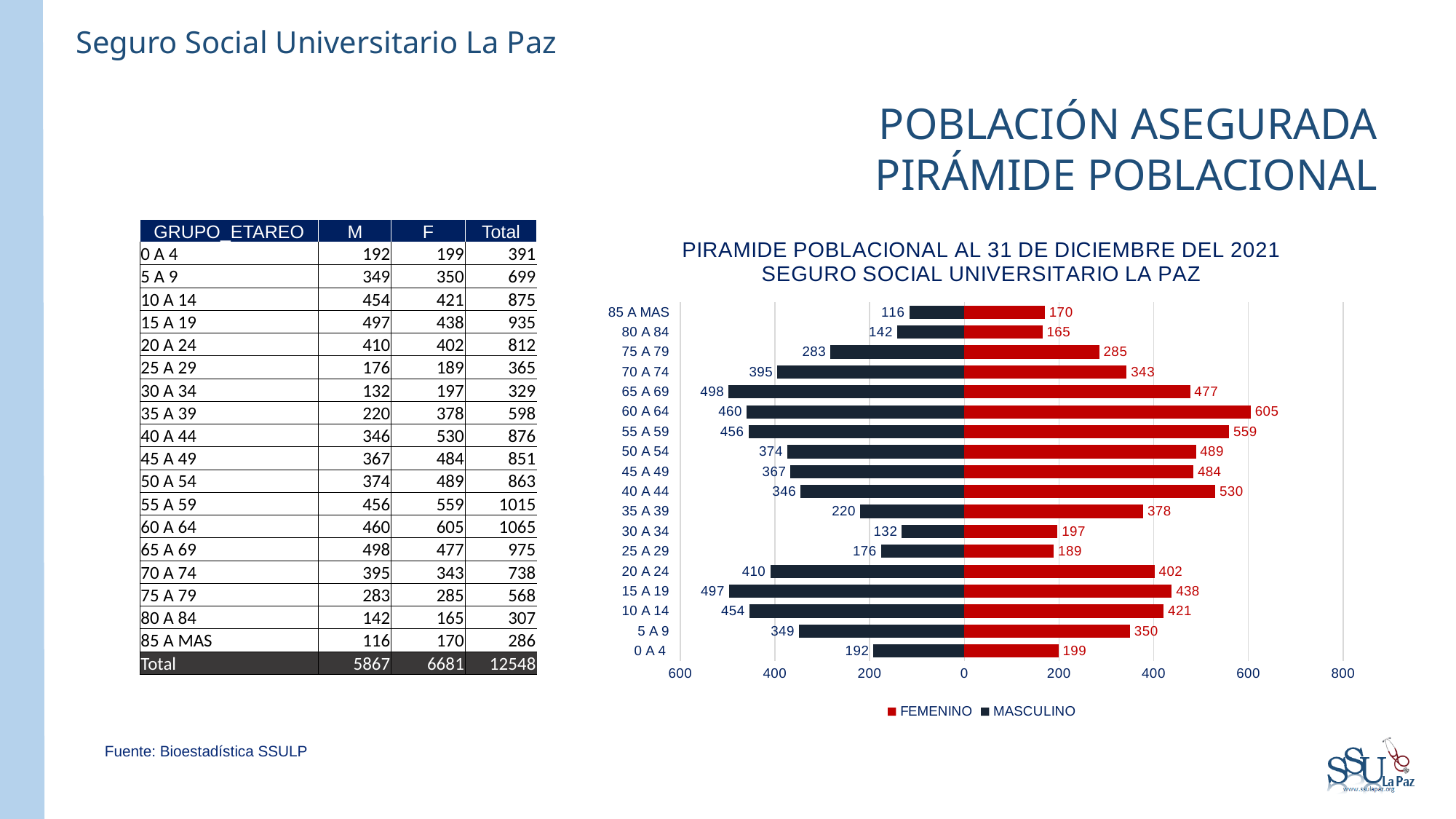
What is the MASCULINO value for the 15 A 19 age group? 497 What is the FEMENINO value for the 85 A MAS age group? 170 How many series does the chart legend list? 2 What colour are the FEMENINO bars in the chart? Red Which age group has the highest FEMENINO value? 60 A 64 What is the FEMENINO value for the 60 A 64 age group? 605 Which age group has the lowest MASCULINO value? 85 A MAS For the 15 A 19 age group, which is larger, the MASCULINO value or the FEMENINO value? MASCULINO Is the FEMENINO value for the 35 A 39 age group greater or less than 200? greater What type of chart is shown on the slide? Bar chart What is the difference between the FEMENINO and MASCULINO values for the 40 A 44 age group? 184 How many age groups are plotted in the chart? 18